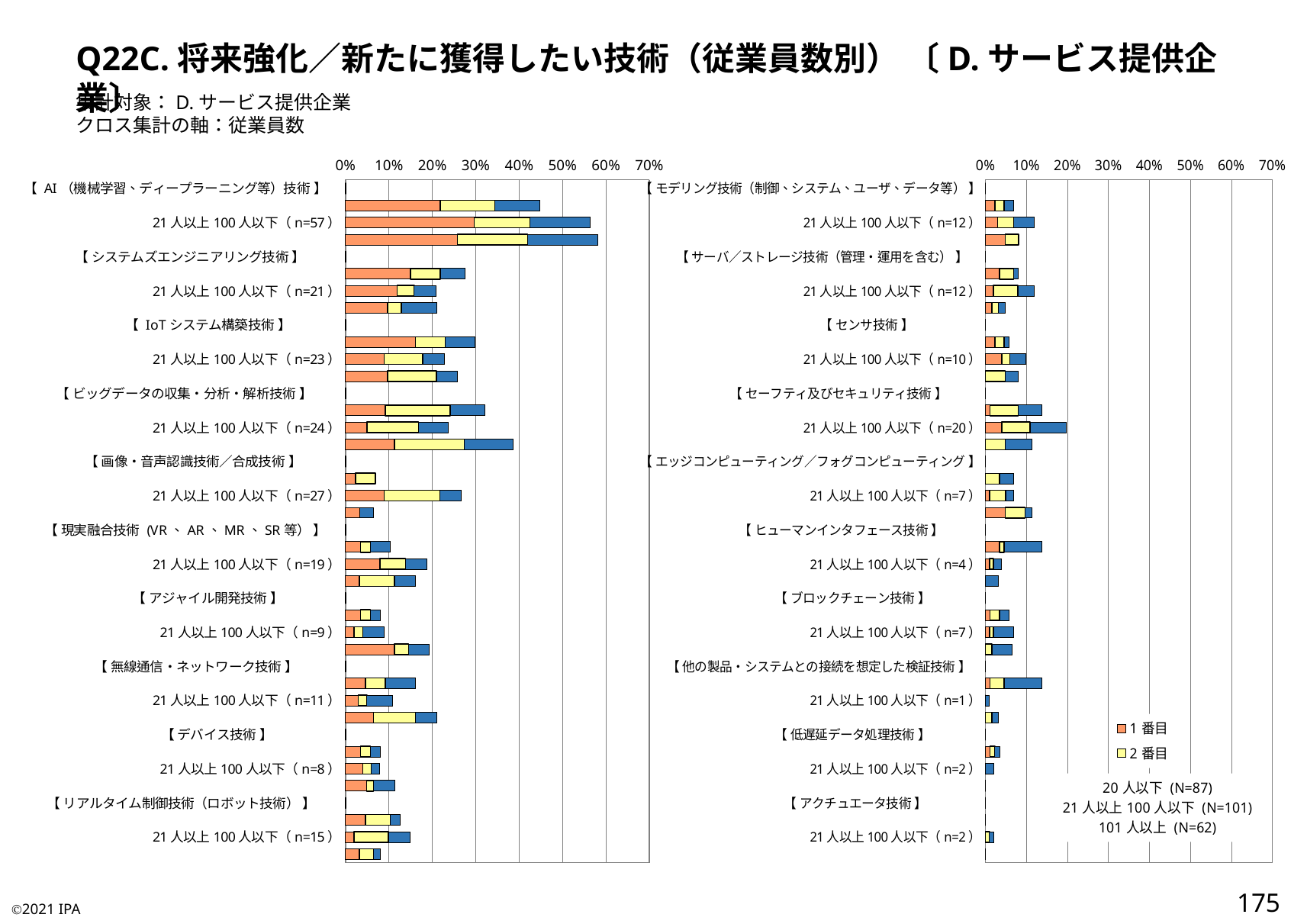
How many technology categories (bracketed headings) are shown in the right chart? 10 In the left chart, is the total bar for 101人以上 under 【AI（機械学習、ディープラーニング等）技術】 greater or less than 50%? greater In the left chart under 【AI（機械学習、ディープラーニング等）技術】, which has the longer total bar: the 20人以下 row or the 101人以上 row? 101人以上 In the left chart, is the total bar for 21人以上100人以下（n=9）under 【アジャイル開発技術】 greater or less than 20%? less What kind of chart is the left chart on the slide? Bar chart How many technology categories (bracketed headings) are shown in the left chart? 10 In the right chart, is the total bar for 21人以上100人以下（n=12）under 【モデリング技術（制御、システム、ユーザ、データ等）】 greater or less than 20%? less In the left chart, which technology category has the longest total bar? 【AI（機械学習、ディープラーニング等）技術】 How many series does the legend on the right chart list? 2 In the right chart's legend, which colour represents 1番目? Orange